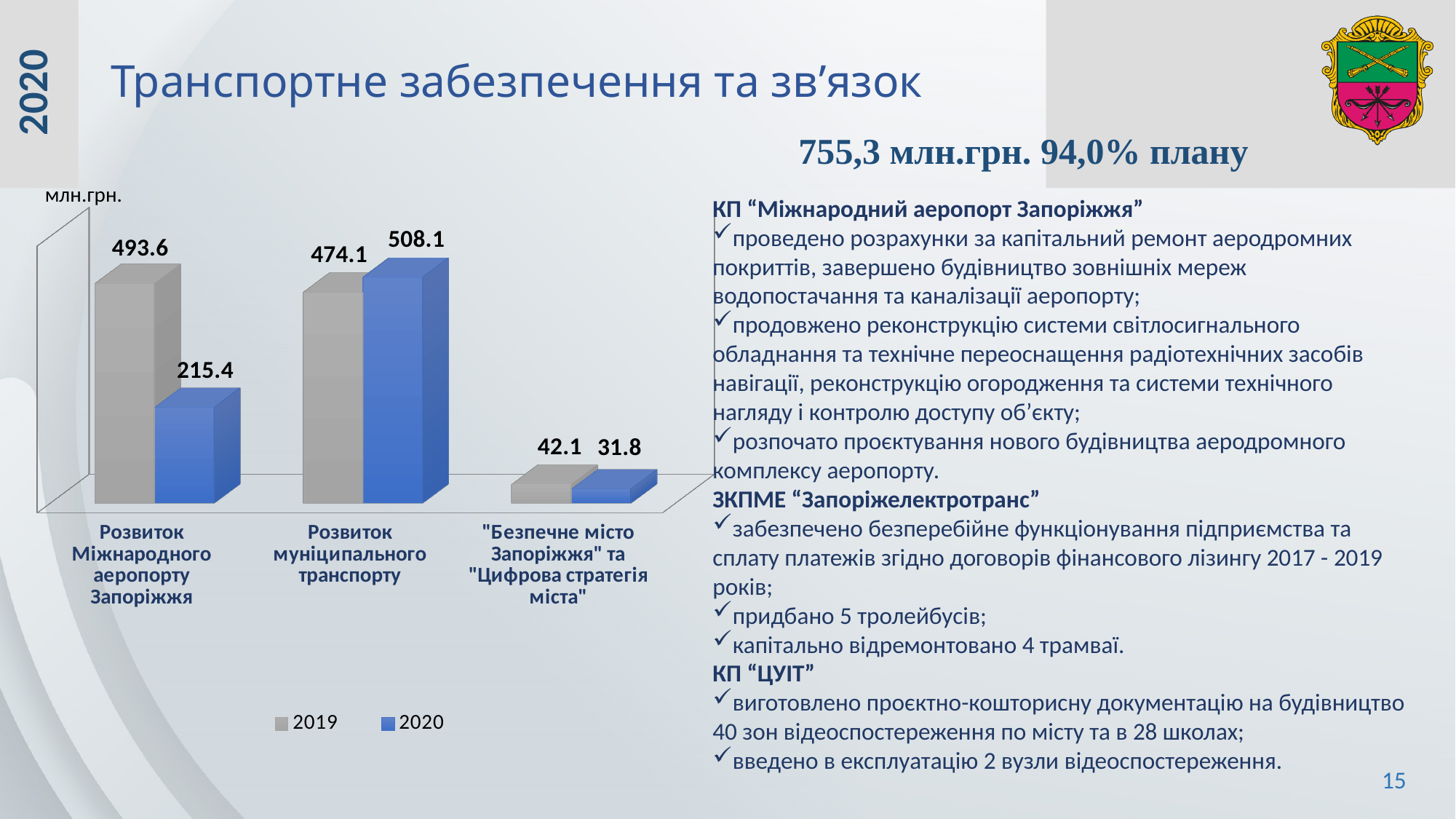
Which category has the lowest 2019 value? "Безпечне місто Запоріжжя" та "Цифрова стратегія міста" What unit is shown above the chart's vertical axis? млн.грн. For Розвиток муніципального транспорту, which year has the larger value, 2019 or 2020? 2020 What kind of chart is shown on the slide? bar chart How many series does the legend list? 2 Which colour represents the 2020 series in the chart? blue What is the 2019 value for Розвиток Міжнародного аеропорту Запоріжжя? 493.6 Which category has the highest 2020 value? Розвиток муніципального транспорту How many categories are shown on the chart? 3 What is the difference between the 2019 and 2020 values for Розвиток Міжнародного аеропорту Запоріжжя? 278.2 What is the 2020 value for Розвиток муніципального транспорту? 508.1 What is the 2020 value for "Безпечне місто Запоріжжя" та "Цифрова стратегія міста"? 31.8